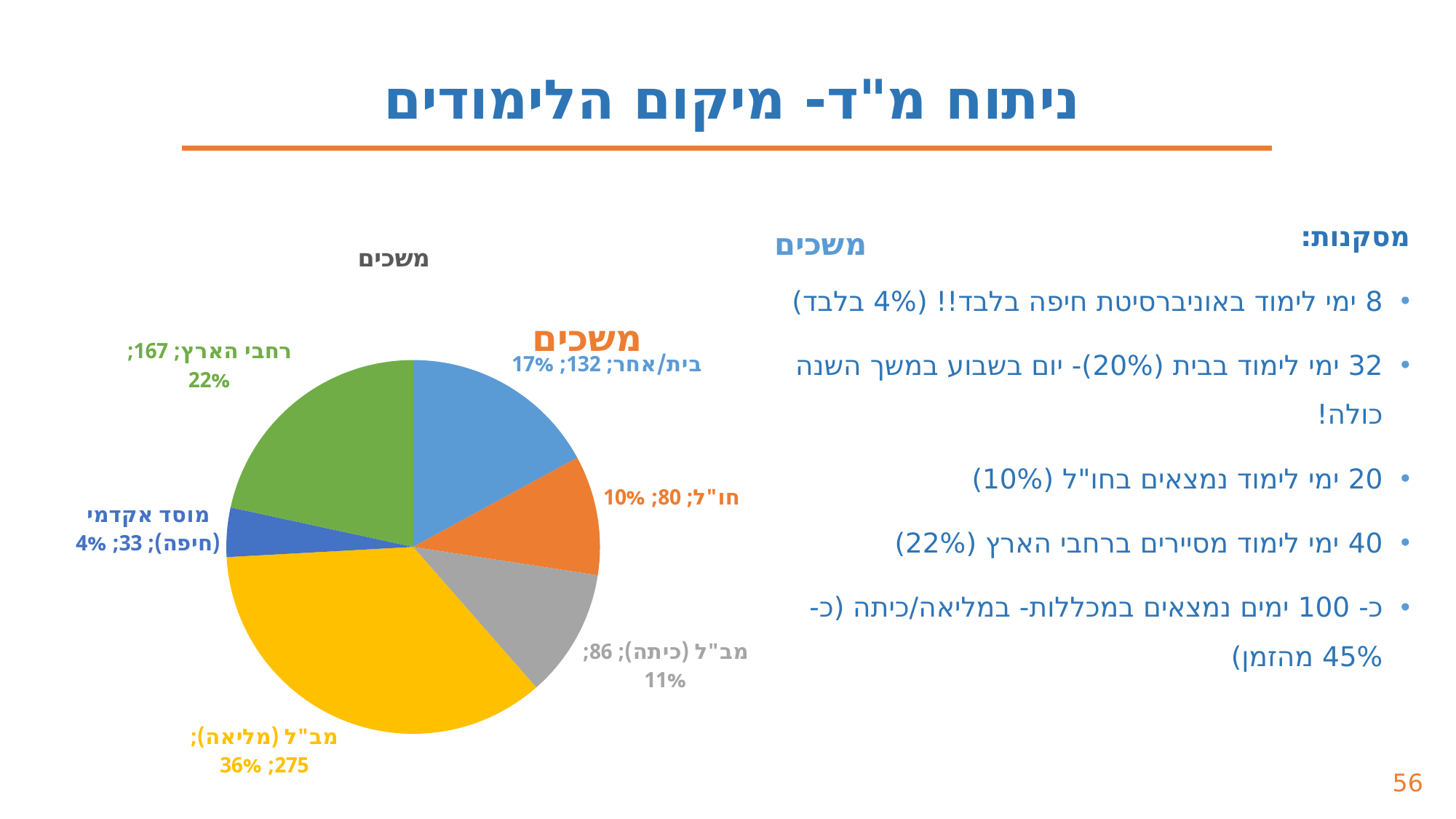
Which slice of the pie chart is the largest? מב"ל (מליאה) What is the difference between the values for רחבי הארץ and בית/אחר? 35 How many slices does the pie chart have? 6 What colour is the slice for מב"ל (מליאה)? yellow Which is larger, the value for מב"ל (כיתה) or the value for חו"ל? מב"ל (כיתה) What value is shown for the slice חו"ל? 80 What is the title of the pie chart? משכים What kind of chart is shown on the slide? pie chart Which slice of the pie chart is the smallest? מוסד אקדמי (חיפה) What percentage share is shown for the slice בית/אחר? 17% What value is shown for the slice מב"ל (מליאה)? 275 What percentage share is shown for the slice רחבי הארץ? 22%